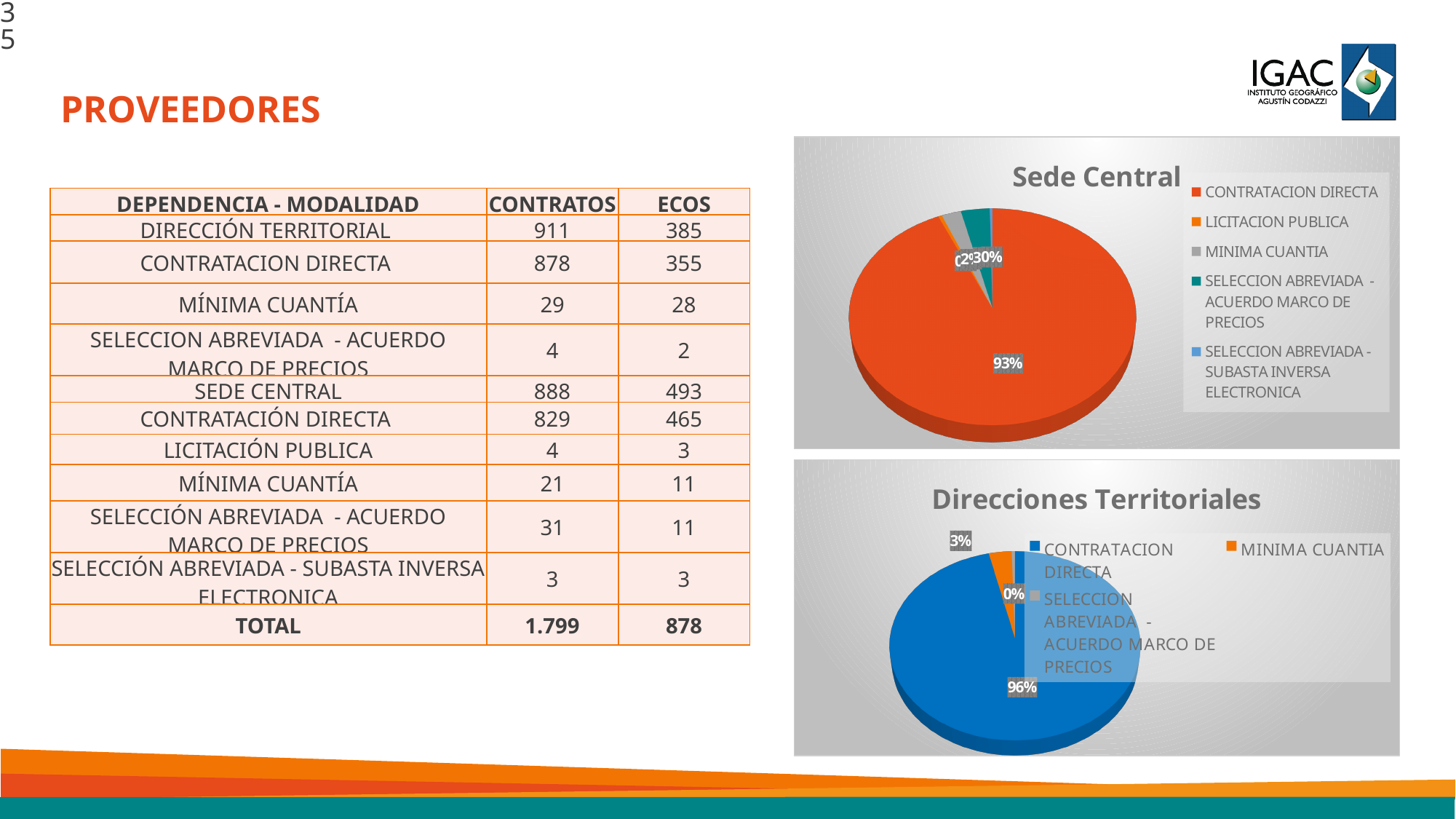
In the "Sede Central" chart, what share of the pie does CONTRATACION DIRECTA have? 93% In the "Direcciones Territoriales" chart, which category has the smallest slice? SELECCION ABREVIADA - ACUERDO MARCO DE PRECIOS What kind of chart is the "Direcciones Territoriales" chart? pie chart What kind of chart is the "Sede Central" chart? pie chart In the "Direcciones Territoriales" chart, what percentage is shown for SELECCION ABREVIADA - ACUERDO MARCO DE PRECIOS? 0% In the "Direcciones Territoriales" chart, which category has the largest slice? CONTRATACION DIRECTA In the "Sede Central" chart, which category has the largest slice? CONTRATACION DIRECTA In the "Direcciones Territoriales" chart, what share of the pie does CONTRATACION DIRECTA have? 96% In the "Direcciones Territoriales" chart, what share of the pie does MINIMA CUANTIA have? 3% How many categories does the legend of the "Direcciones Territoriales" chart list? 3 How many categories does the legend of the "Sede Central" chart list? 5 In the "Direcciones Territoriales" chart, which is larger: the slice for CONTRATACION DIRECTA or the slice for MINIMA CUANTIA? CONTRATACION DIRECTA